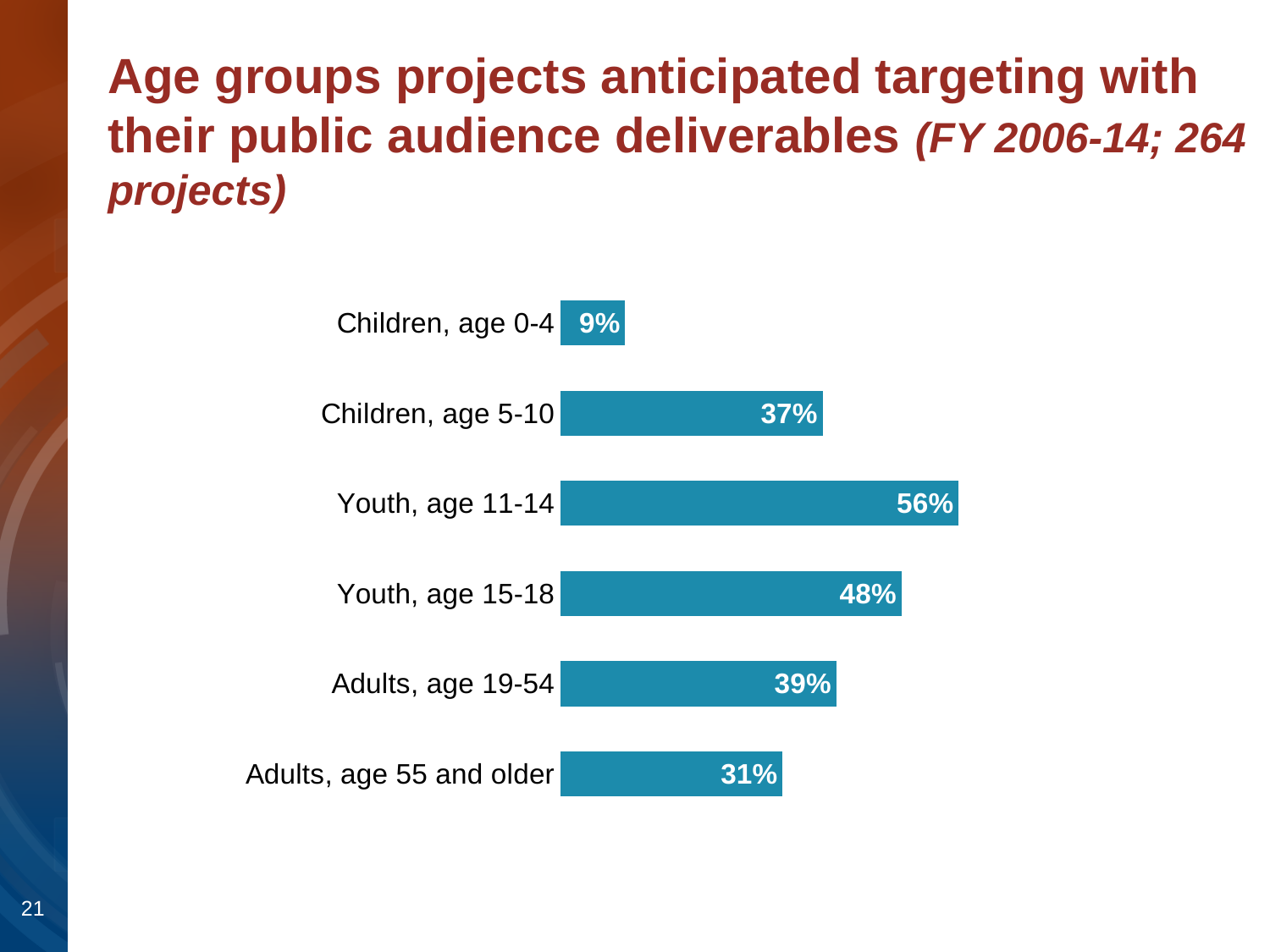
How many age groups are shown in the chart? 6 Which age group has the highest percentage? Youth, age 11-14 What percentage of projects anticipated targeting Youth, age 11-14? 56% What is the value for Adults, age 19-54? 39% Which has a larger value, Adults, age 19-54 or Children, age 5-10? Adults, age 19-54 What is the difference between the values for Children, age 5-10 and Children, age 0-4? 28% What percentage is shown for Adults, age 55 and older? 31% How many projects does the chart title say the data covers? 264 projects Which age group has the lowest percentage? Children, age 0-4 What is the difference between the values for Youth, age 11-14 and Youth, age 15-18? 8% What is the value shown for Children, age 0-4? 9% What type of chart is shown on the slide? Bar chart